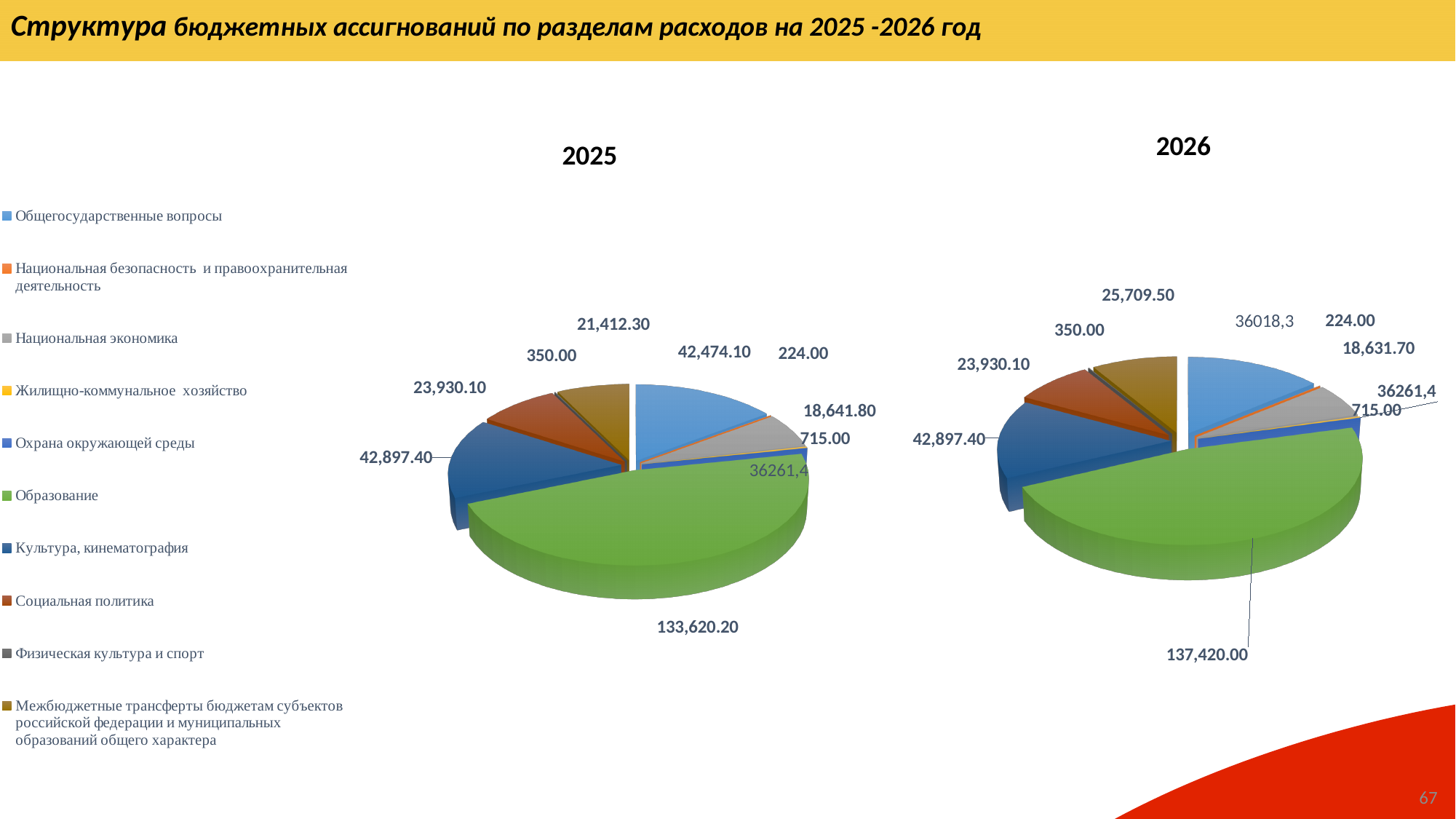
In the 2025 chart, which is larger: Культура, кинематография or Социальная политика? Культура, кинематография How much larger is the value for Образование in the 2026 chart than in the 2025 chart? 3,799.80 In the 2026 chart, what is the value for Образование? 137,420.00 In the 2025 chart, what is the value for Культура, кинематография? 42,897.40 What type of chart is used for the 2025 data? Pie chart In the 2026 chart, what is the value for Межбюджетные трансферты бюджетам субъектов российской федерации и муниципальных образований общего характера? 25,709.50 How many categories does the legend list? 10 In the 2025 chart, what is the value for Образование? 133,620.20 In the 2025 chart, what is the value for Физическая культура и спорт? 350.00 In the 2026 chart, which category has the largest slice? Образование In the 2026 chart, what is the value for Национальная экономика? 18,631.70